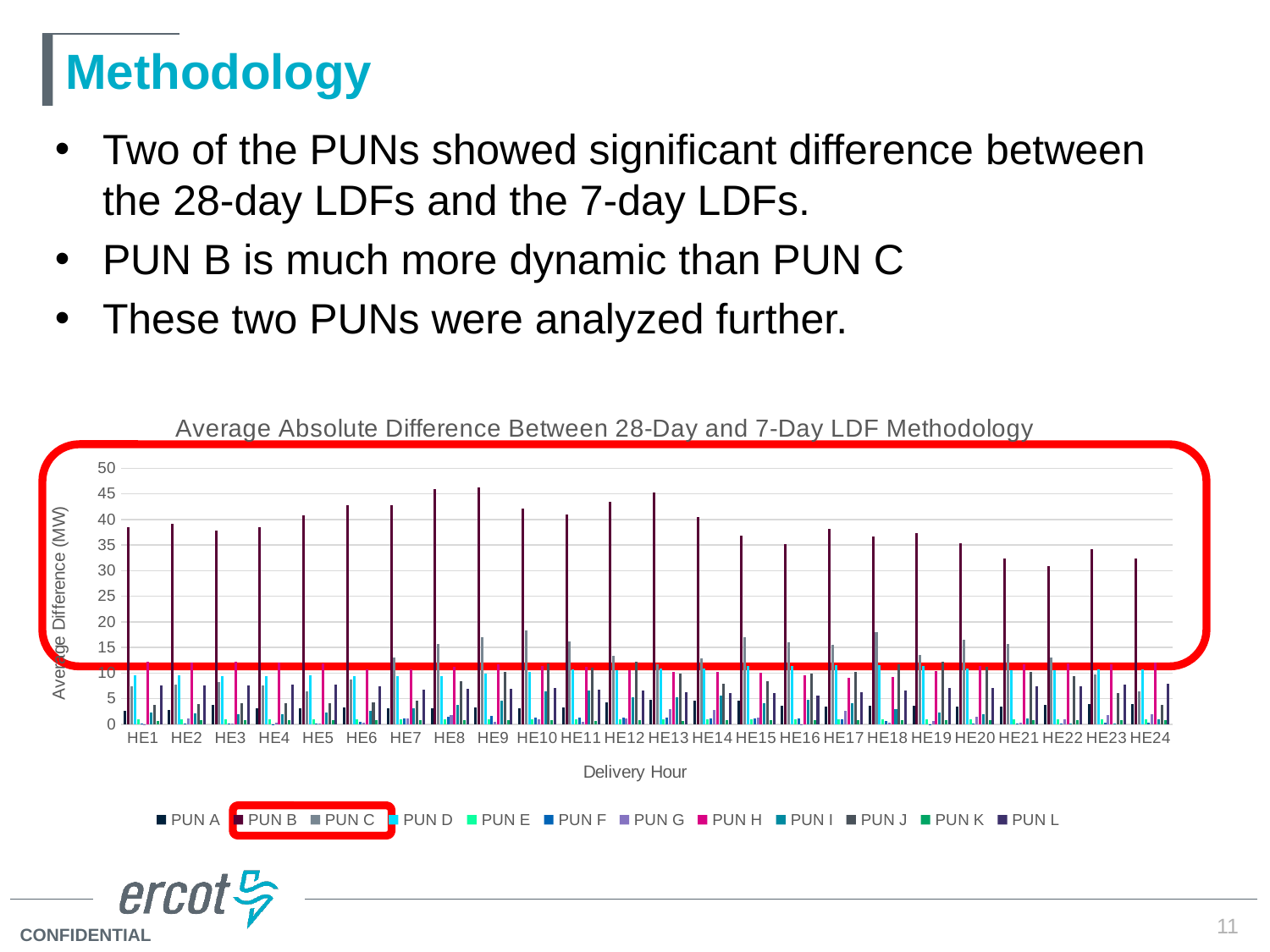
What is the title of the chart? Average Absolute Difference Between 28-Day and 7-Day LDF Methodology What kind of chart is shown on the slide? bar chart Is the value for PUN B at HE9 greater or less than 40? greater Is the value for PUN B at HE22 greater or less than 35? less At HE1, which series has the larger value, PUN B or PUN C? PUN B What is the label of the chart's vertical axis? Average Difference (MW) How many series does the chart's legend list? 12 How many delivery hour categories are shown on the x axis of the chart? 24 Which is larger, the value for PUN B at HE9 or the value for PUN B at HE22? PUN B at HE9 Is the value for PUN C at HE10 greater or less than 25? less Do the values for PUN B generally rise or fall from HE13 to HE22? fall